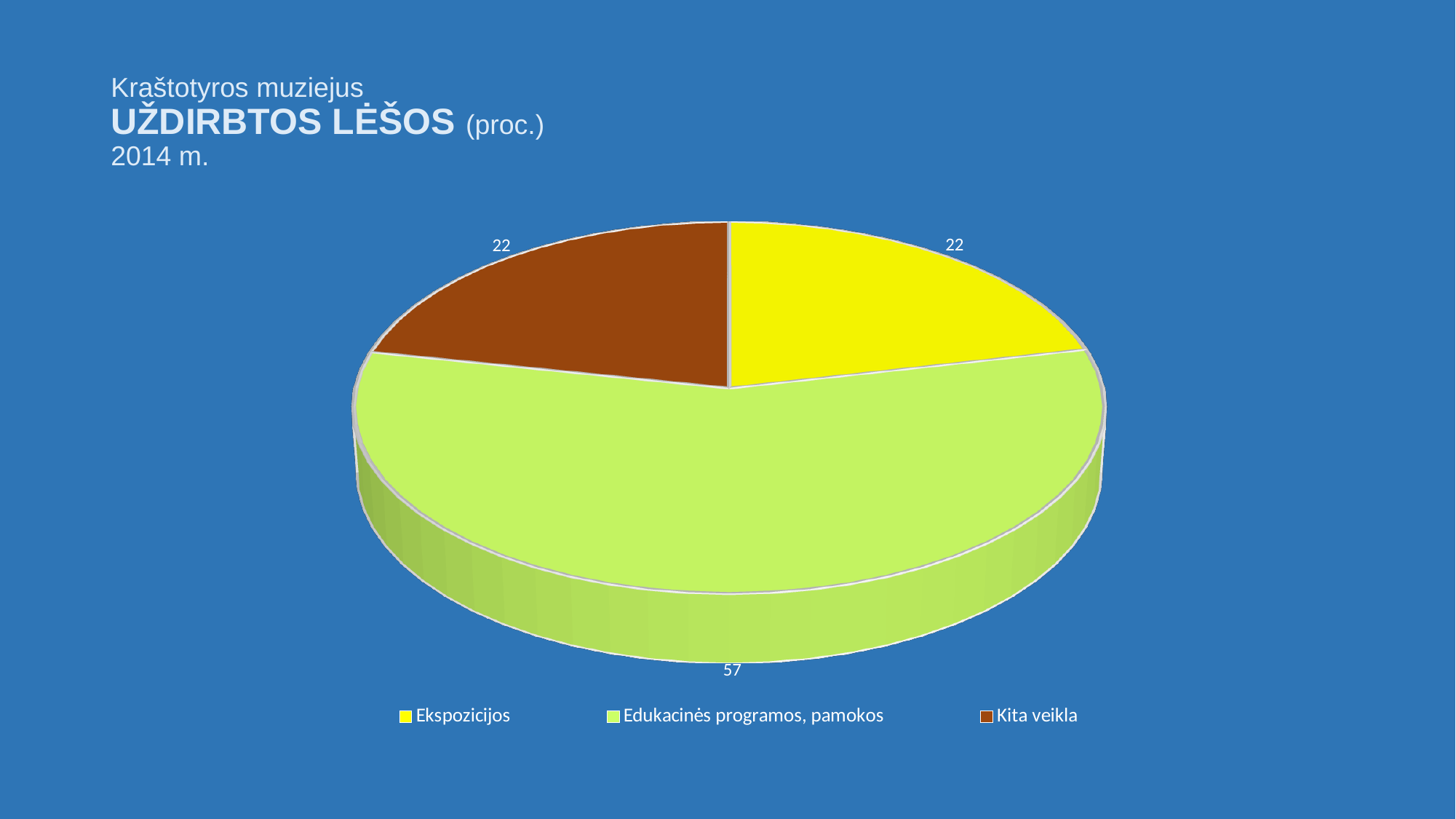
Which category has the largest slice of the pie? Edukacinės programos, pamokos How many entries does the legend list? 3 What value is shown for Kita veikla? 22 What is the difference between the values for Edukacinės programos, pamokos and Kita veikla? 35 What kind of chart is shown on the slide? Pie chart What colour is the Kita veikla slice? Brown Which year does the chart title refer to? 2014 m. What value is shown for Edukacinės programos, pamokos? 57 What value is shown for Ekspozicijos? 22 Which is larger, the value for Edukacinės programos, pamokos or the value for Kita veikla? Edukacinės programos, pamokos What is the difference between the values for Edukacinės programos, pamokos and Ekspozicijos? 35 How many slices does the pie chart have? 3